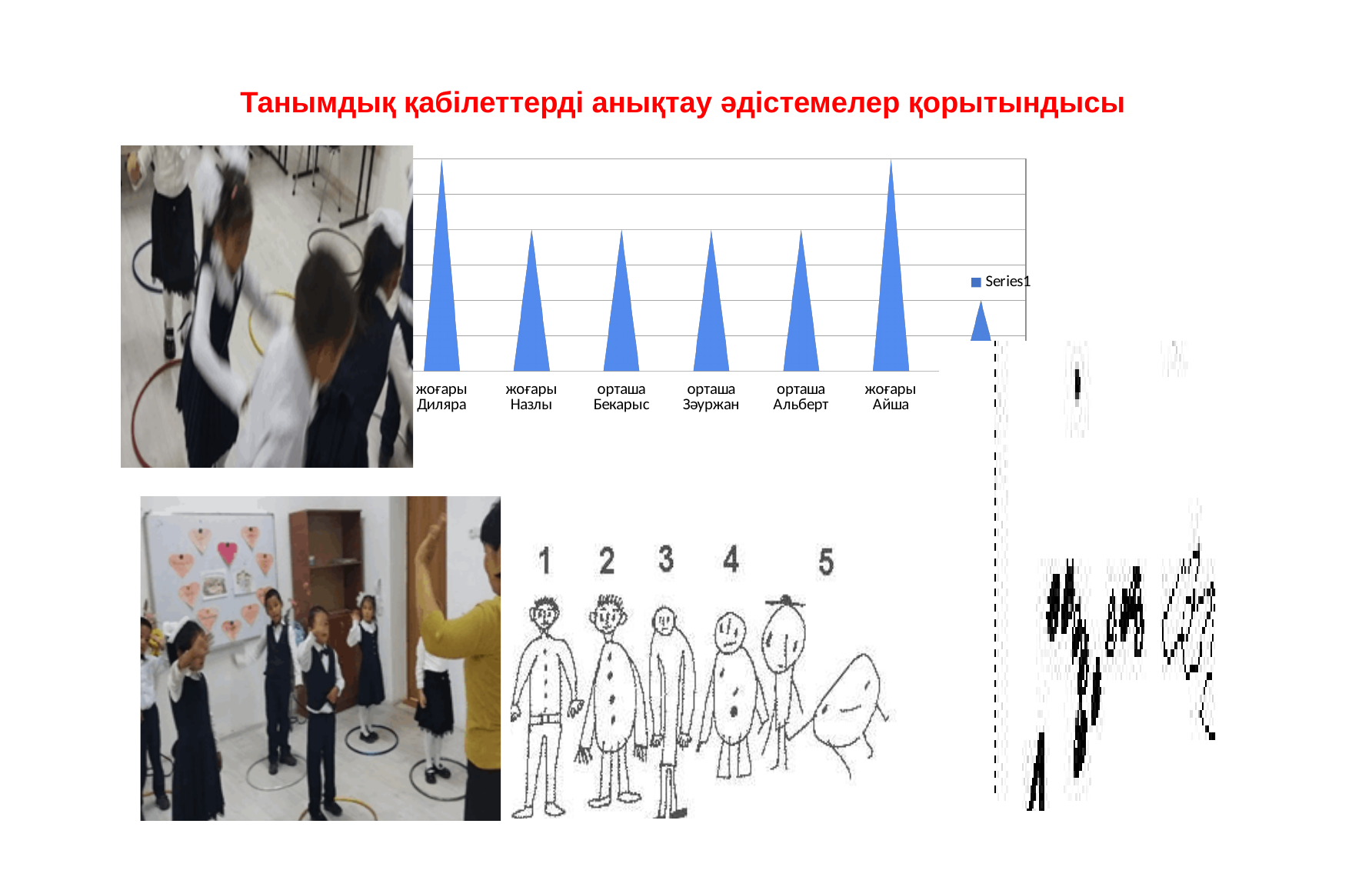
Which is larger in the chart, the value for орташа Бекарыс or the value for жоғары Айша? жоғары Айша Do the values in the chart rise steadily, fall steadily, or neither from left to right? neither What is the label of the first category on the x axis of the chart? жоғары Диляра What kind of chart is shown on the slide? bar chart Which is larger in the chart, the value for жоғары Диляра or the value for орташа Зәуржан? жоғары Диляра What is the name of the series shown in the chart legend? Series1 Which is larger in the chart, the value for жоғары Айша or the value for орташа Альберт? жоғары Айша How many series does the chart legend list? 1